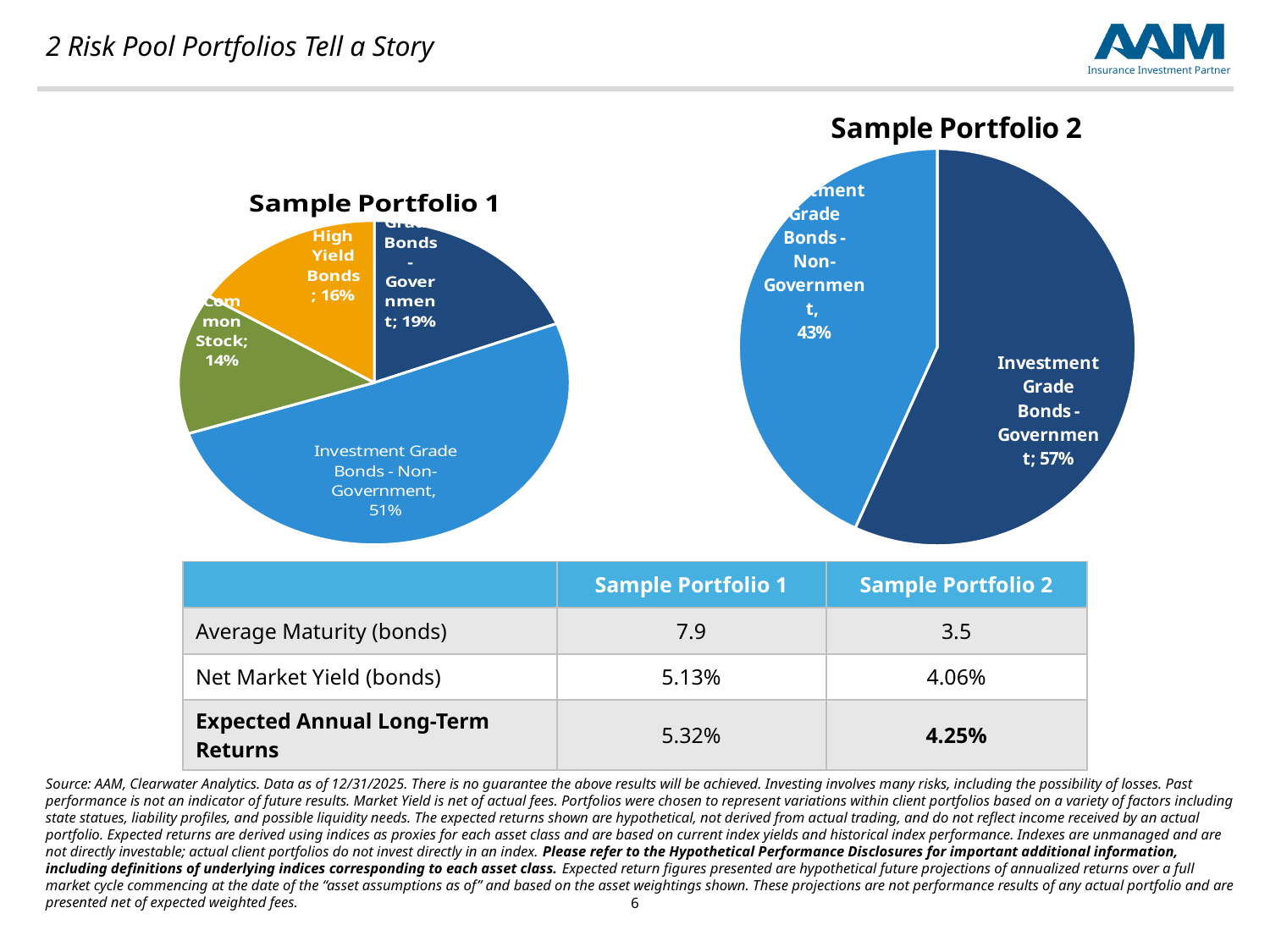
In the Sample Portfolio 1 chart, which asset class has the smallest slice? Common Stock In the Sample Portfolio 1 chart, what share of the portfolio is Investment Grade Bonds - Non-Government? 51% How many slices does the Sample Portfolio 2 pie chart have? 2 In the Sample Portfolio 2 chart, what share of the portfolio is Investment Grade Bonds - Non-Government? 43% In the Sample Portfolio 1 chart, how many percentage points larger is the High Yield Bonds slice than the Common Stock slice? 2 percentage points What kind of chart is the Sample Portfolio 1 chart? Pie chart In the Sample Portfolio 1 chart, what share of the portfolio is High Yield Bonds? 16% In the Sample Portfolio 1 chart, which asset class has the largest slice? Investment Grade Bonds - Non-Government How many slices does the Sample Portfolio 1 pie chart have? 4 Which chart shows a larger share for Investment Grade Bonds - Non-Government, Sample Portfolio 1 or Sample Portfolio 2? Sample Portfolio 1